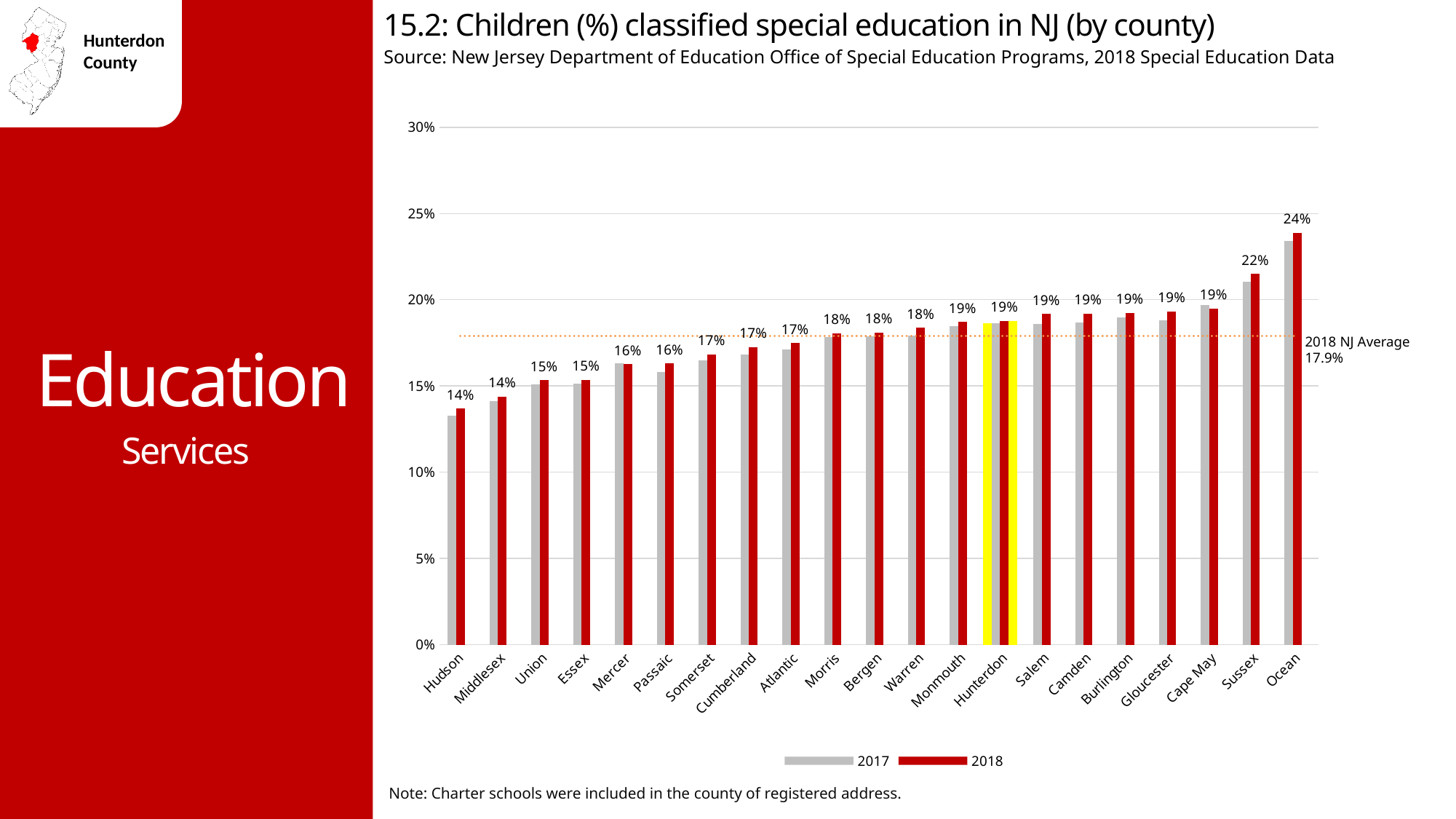
Do the 2018 values rise or fall moving from left to right along the x axis? Rise What kind of chart is shown on the slide? Bar chart Which county has the highest 2018 percentage of children classified special education? Ocean What is the 2018 value for Hunterdon county? 19% What is the 2018 value for Ocean county? 24% What is the 2018 value for Sussex county? 22% What is the difference between the 2018 values for Ocean and Hudson counties? 10 percentage points Is the 2017 value for Hudson county greater or less than 15%? less How many counties are shown on the x axis? 21 Which county has a larger 2018 value, Sussex or Cape May? Sussex What is the 2018 NJ average shown by the dotted line? 17.9% How many series does the legend list? 2